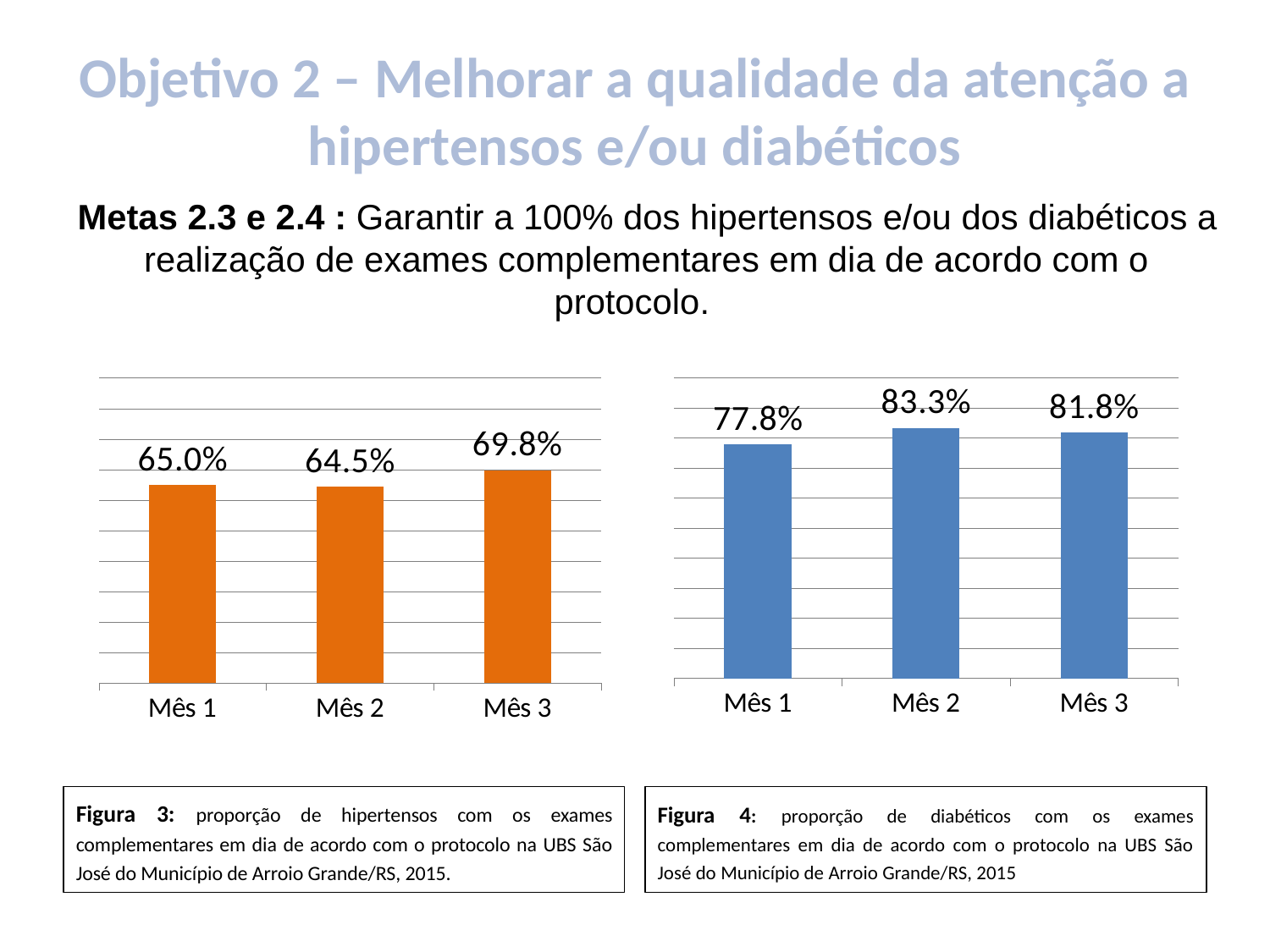
In the right chart (Figura 4, diabéticos), what is the difference between the values for Mês 2 and Mês 3? 1.5% What kind of chart is the right chart (Figura 4)? Bar chart Which is larger: the value for Mês 1 in the left chart (hipertensos) or the value for Mês 1 in the right chart (diabéticos)? Mês 1 in the right chart (diabéticos) In the left chart (Figura 3, hipertensos), what is the difference between the values for Mês 3 and Mês 1? 4.8% In the right chart (Figura 4, diabéticos), which month has the highest value? Mês 2 In the right chart (Figura 4, diabéticos), what is the value for Mês 1? 77.8% In the left chart (Figura 3, hipertensos), which month has the highest value? Mês 3 In the left chart (Figura 3, hipertensos), what is the value for Mês 3? 69.8% In the right chart (Figura 4, diabéticos), which month has the lowest value? Mês 1 How many months (categories) are shown in the left chart (Figura 3)? 3 In the left chart (Figura 3, hipertensos), which month has the lowest value? Mês 2 What colour are the bars in the left chart (Figura 3, hipertensos)? Orange